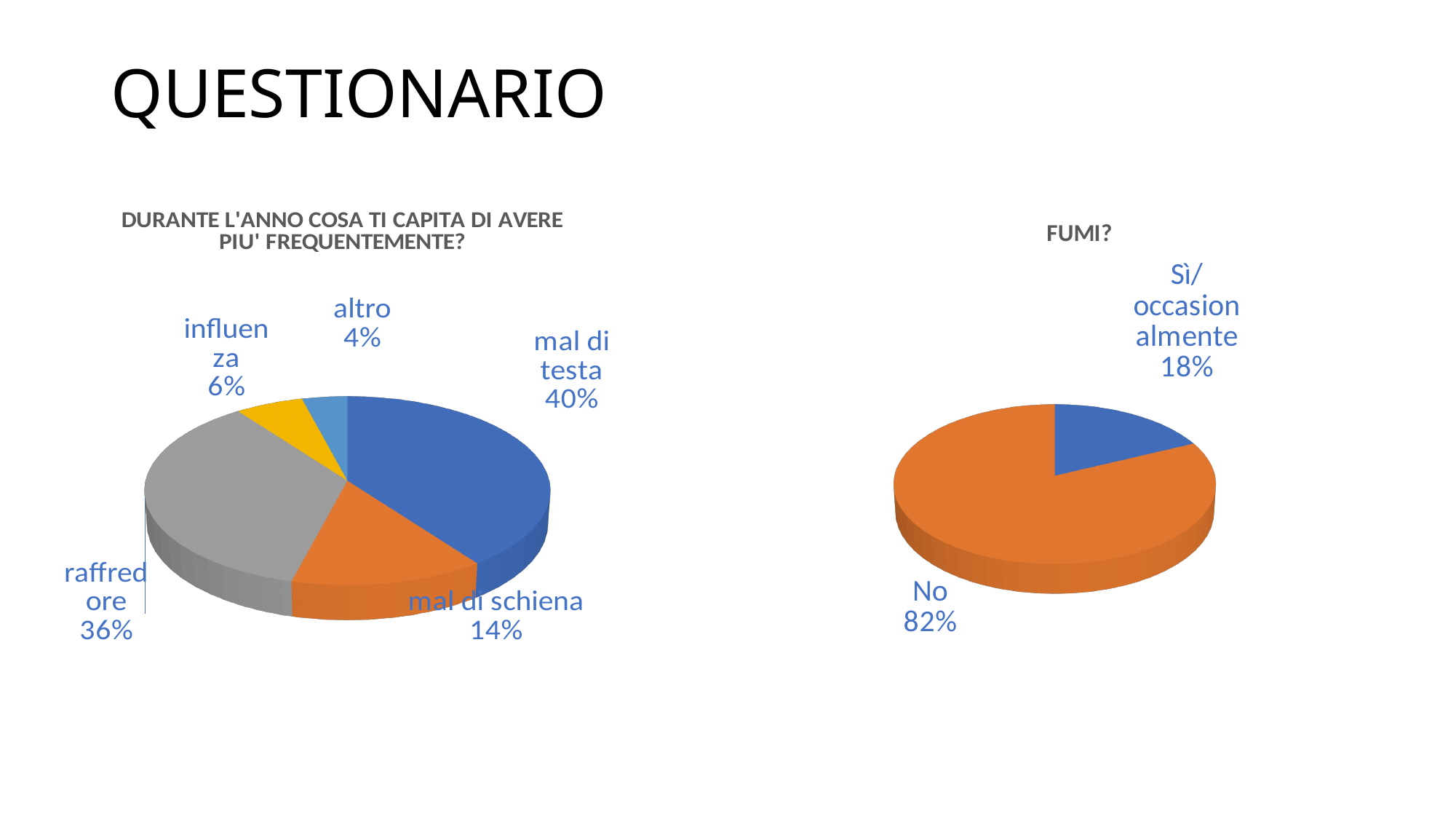
What kind of chart is the right chart 'FUMI?'? pie chart In the left chart 'DURANTE L'ANNO COSA TI CAPITA DI AVERE PIU' FREQUENTEMENTE?', what share is 'raffreddore'? 36% In the right chart 'FUMI?', what share is 'Sì/occasionalmente'? 18% In the left chart 'DURANTE L'ANNO COSA TI CAPITA DI AVERE PIU' FREQUENTEMENTE?', which is larger, 'mal di schiena' or 'influenza'? mal di schiena In the left chart 'DURANTE L'ANNO COSA TI CAPITA DI AVERE PIU' FREQUENTEMENTE?', which category has the smallest slice? altro In the left chart 'DURANTE L'ANNO COSA TI CAPITA DI AVERE PIU' FREQUENTEMENTE?', how many categories are shown? 5 In the left chart 'DURANTE L'ANNO COSA TI CAPITA DI AVERE PIU' FREQUENTEMENTE?', what share is 'mal di testa'? 40% In the left chart 'DURANTE L'ANNO COSA TI CAPITA DI AVERE PIU' FREQUENTEMENTE?', what is the difference in percentage points between 'mal di testa' and 'raffreddore'? 4 In the left chart 'DURANTE L'ANNO COSA TI CAPITA DI AVERE PIU' FREQUENTEMENTE?', which category has the largest slice? mal di testa